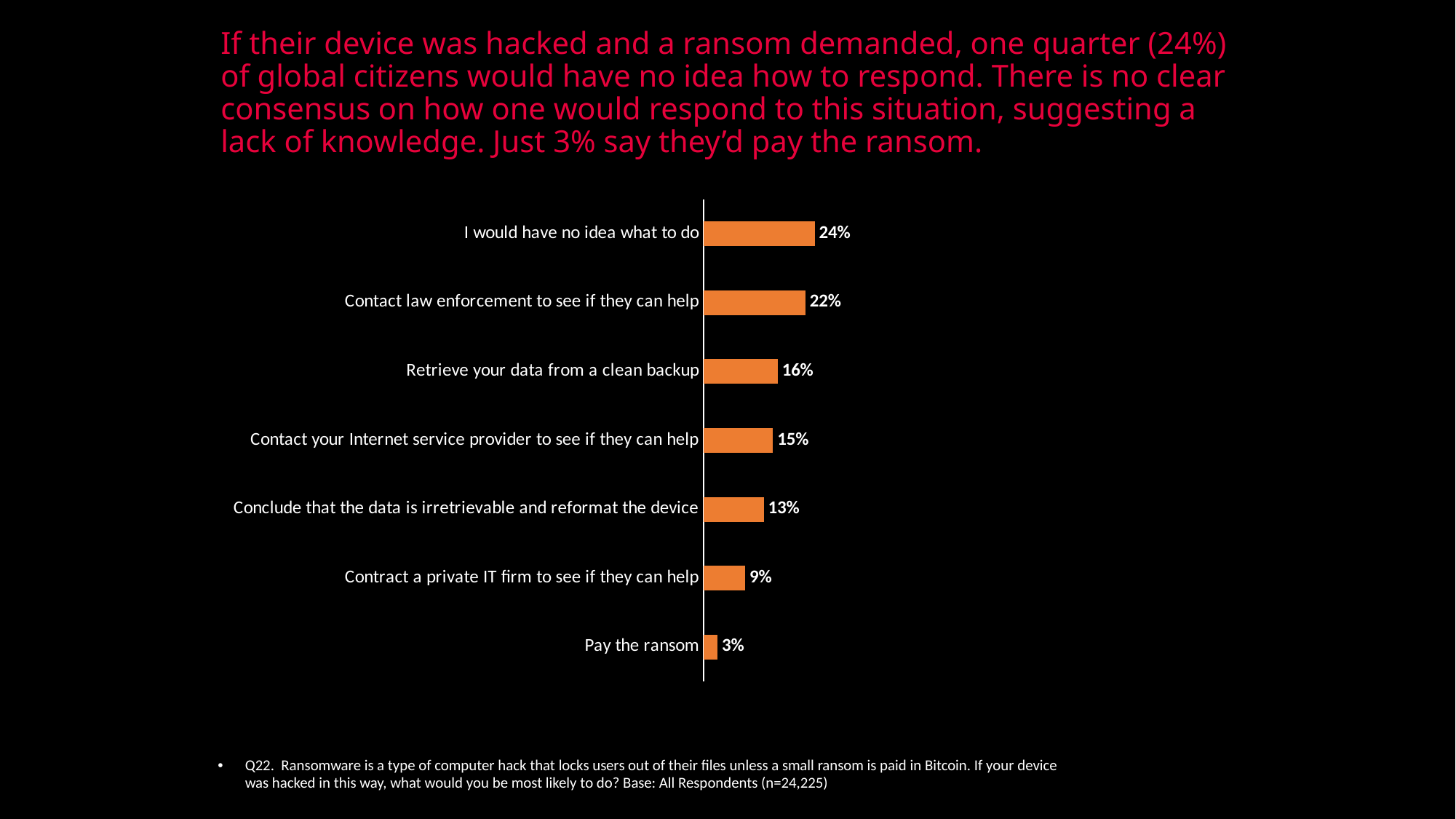
How many response categories are shown in the chart? 7 What percentage of respondents said they would have no idea what to do? 24% What percentage would retrieve their data from a clean backup? 16% What is the value for "Contract a private IT firm to see if they can help"? 9% Which is larger: "Contact your Internet service provider to see if they can help" or "Conclude that the data is irretrievable and reformat the device"? Contact your Internet service provider to see if they can help What is the difference between "Contact law enforcement to see if they can help" and "Retrieve your data from a clean backup"? 6% What is the difference between "I would have no idea what to do" and "Pay the ransom"? 21% Which response has the lowest percentage? Pay the ransom Which response has the highest percentage? I would have no idea what to do What colour are the bars in the chart? Orange What is the value for "Contact law enforcement to see if they can help"? 22% What type of chart is shown on the slide? Bar chart